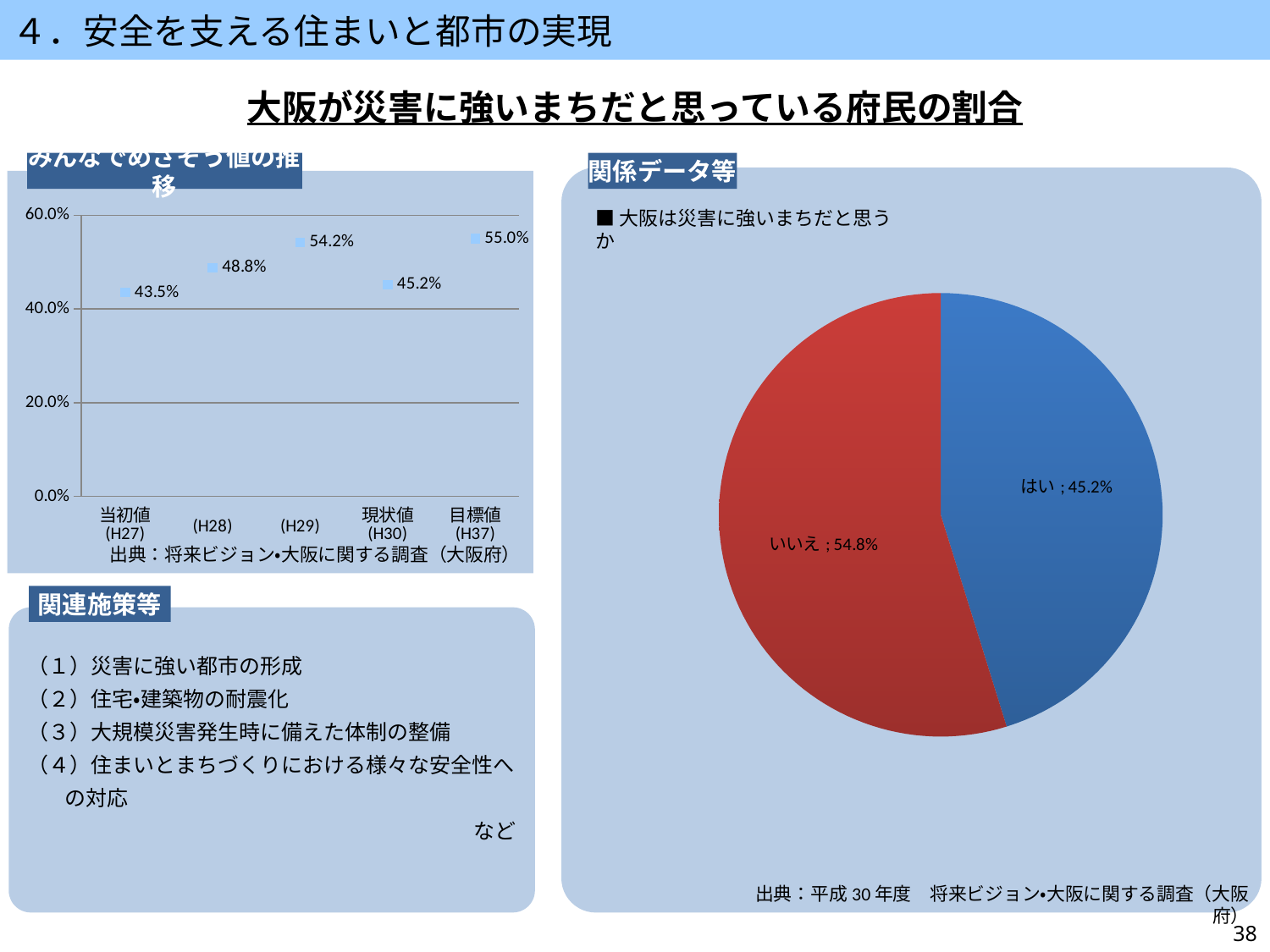
In the left chart (みんなでめざそう値の推移), which category has the lowest value? 当初値 (H27) In the left chart (みんなでめざそう値の推移), is the value for H28 greater or less than 40.0%? greater In the left chart (みんなでめざそう値の推移), what is the value for H29? 54.2% In the pie chart on the right, which slice is larger, はい or いいえ? いいえ In the left chart (みんなでめざそう値の推移), which category has the highest value? 目標値 (H37) In the left chart (みんなでめざそう値の推移), how many data points are plotted? 5 What type of chart is shown on the right side of the slide? Pie chart In the left chart (みんなでめざそう値の推移), what is the value for 目標値 (H37)? 55.0% In the left chart (みんなでめざそう値の推移), what is the difference between the H29 value and the 現状値 (H30) value? 9.0% In the left chart (みんなでめざそう値の推移), what is the value for 当初値 (H27)? 43.5% In the left chart (みんなでめざそう値の推移), what is the value for 現状値 (H30)? 45.2% In the pie chart on the right, what share is labelled いいえ? 54.8%